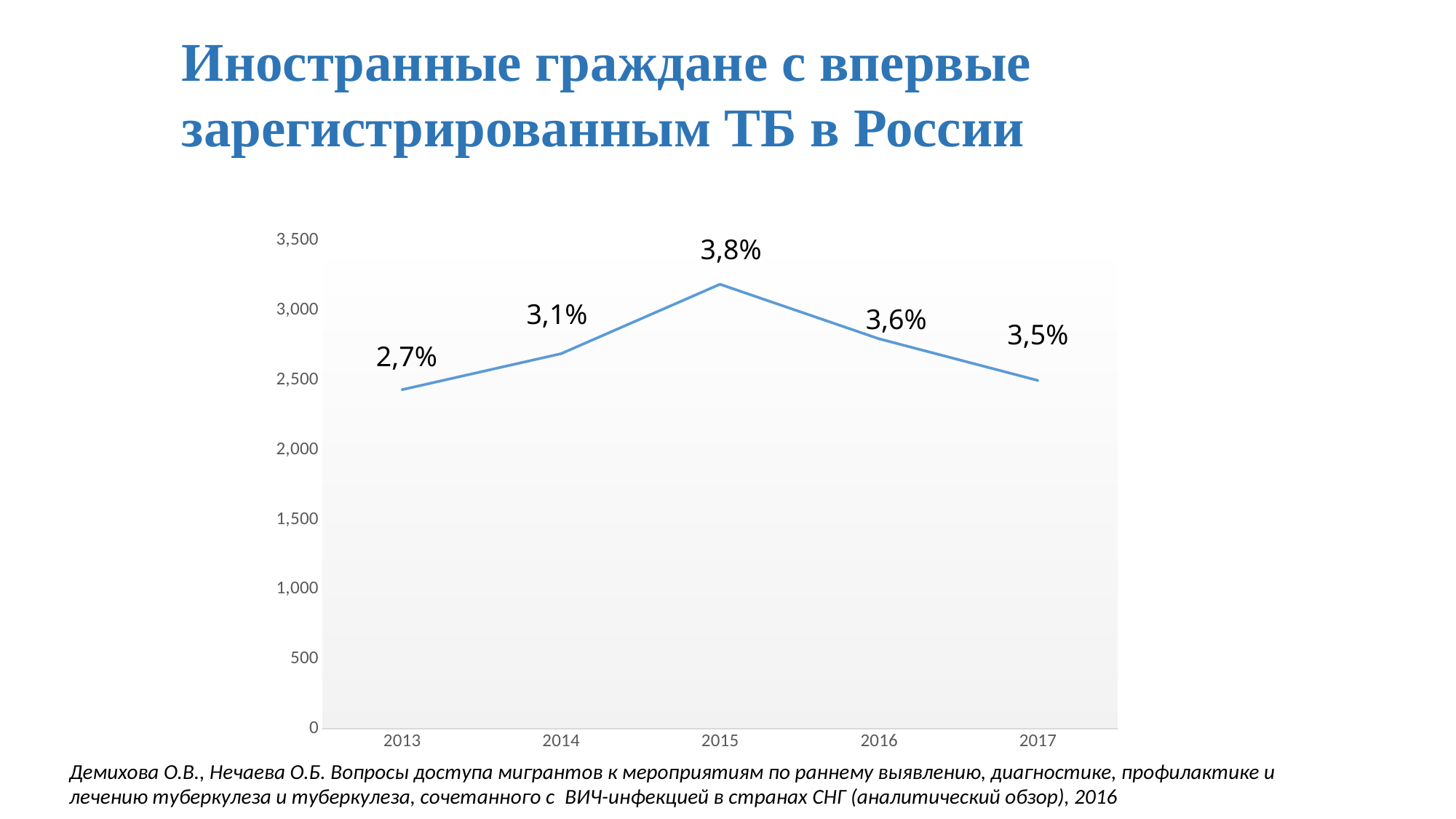
What data label is shown for 2013? 2,7% Which year has the lowest percentage label on the chart? 2013 What data label is shown for 2015? 3,8% Which year has the highest value on the chart? 2015 What data label is shown for 2017? 3,5% Is the plotted value for 2016 greater or less than 2,500? greater Is the plotted value for 2013 greater or less than 2,500? less Which year has the higher value, 2014 or 2016? 2016 Is the plotted value for 2015 greater or less than 3,000? greater What kind of chart is shown on the slide? line chart How many data points are plotted on the line? 5 Does the line rise or fall from 2015 to 2017? fall